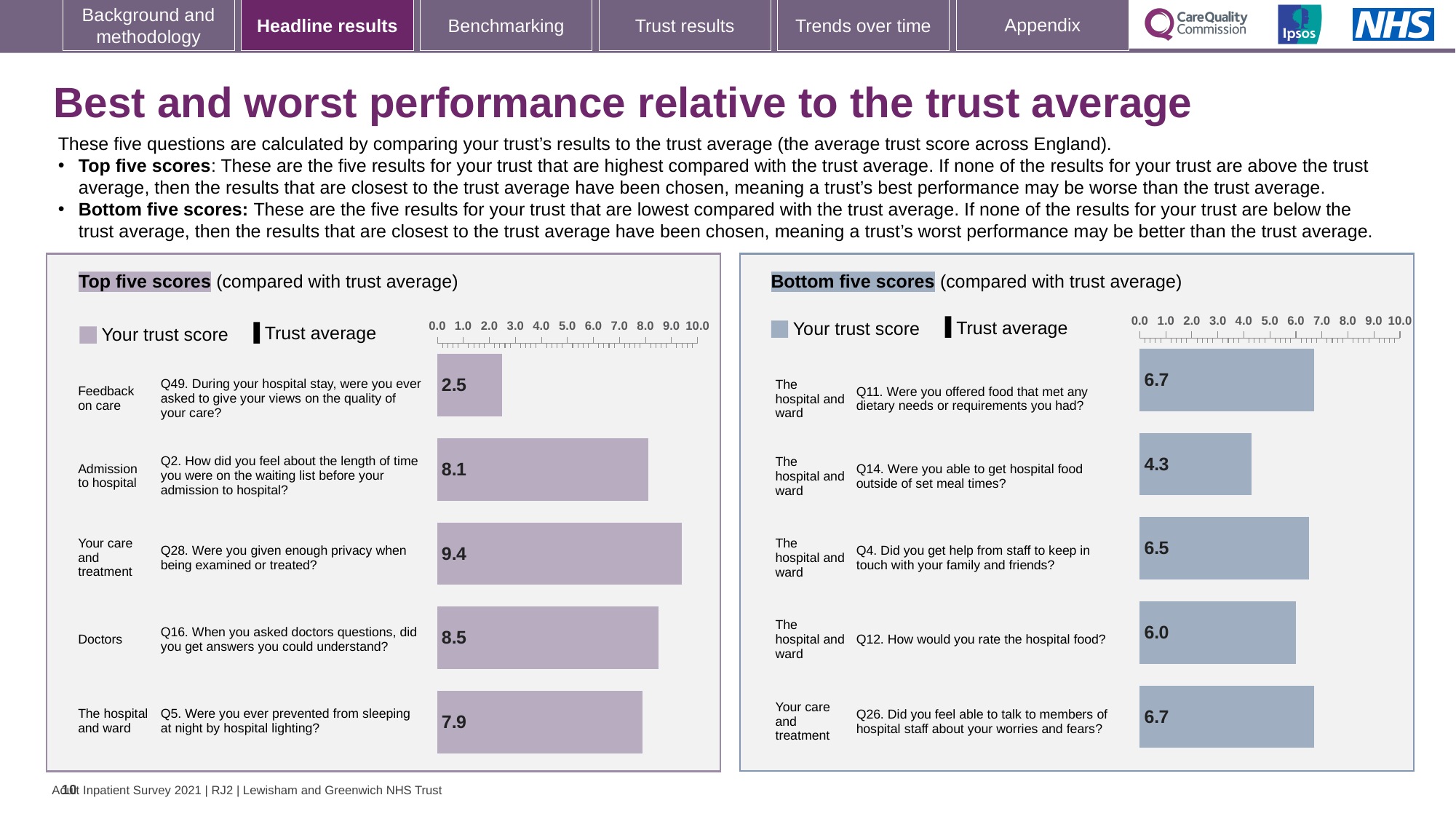
In the Bottom five scores chart, what is the difference between the trust scores for Q11 and Q12? 0.7 In the Top five scores chart, what is the difference between the trust scores for Q16 and Q2? 0.4 In the Top five scores chart, what is the trust score for Q5 (Were you ever prevented from sleeping at night by hospital lighting?)? 7.9 In the Bottom five scores chart, which has the larger trust score, Q4 or Q12? Q4 In the Bottom five scores chart, which question has the lowest trust score? Q14 How many entries does the legend of the Top five scores chart list? 2 In the Top five scores chart, which question has the highest trust score? Q28 In the Top five scores chart, which question has the lowest trust score? Q49 In the Top five scores chart, what is the trust score for Q28 (Were you given enough privacy when being examined or treated?)? 9.4 How many questions are shown in the Top five scores chart? 5 In the Bottom five scores chart, what is the trust score for Q14 (Were you able to get hospital food outside of set meal times?)? 4.3 What type of chart is the Bottom five scores chart? Bar chart